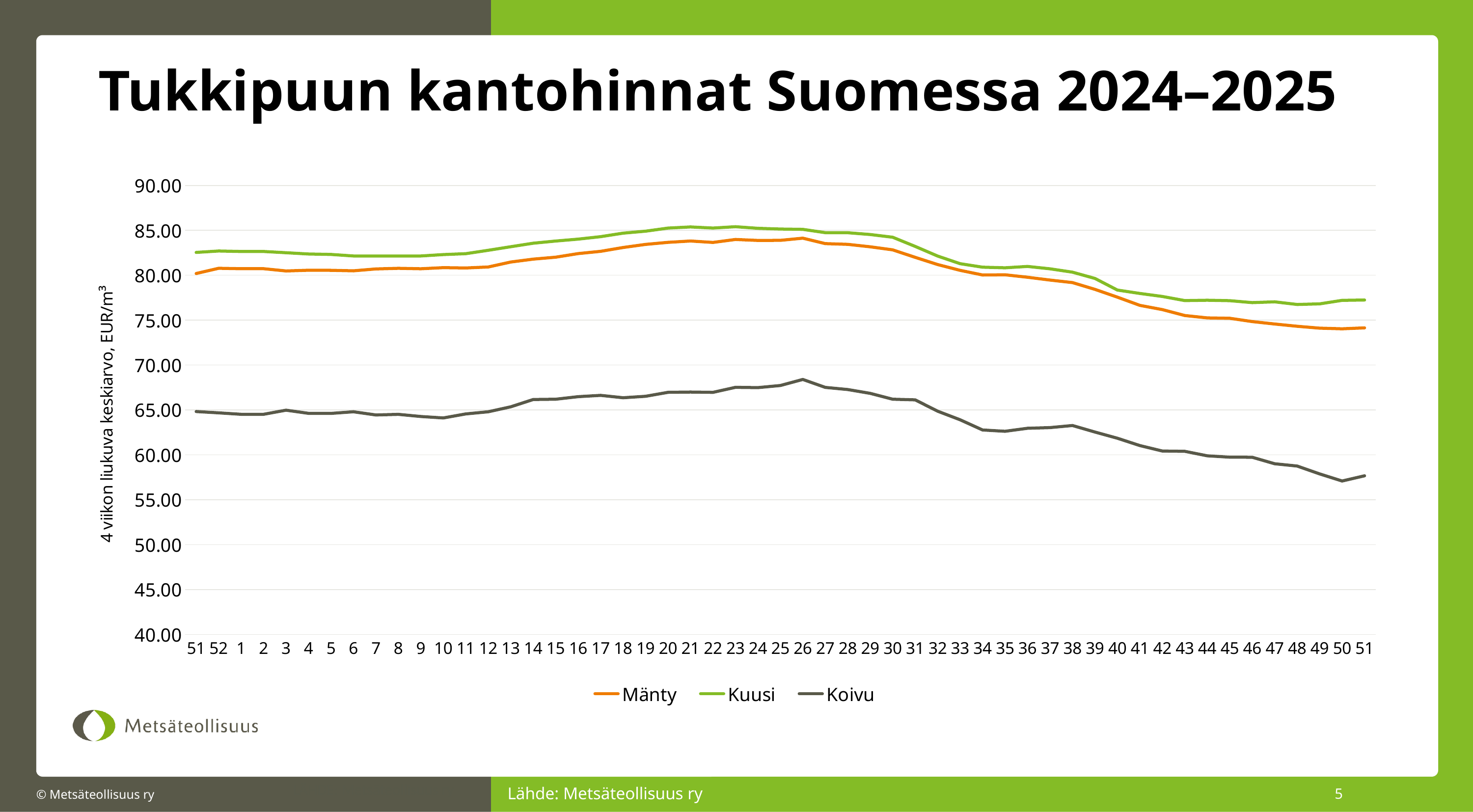
Is the value for Kuusi at week 1 greater or less than 80? greater Does the Koivu line rise or fall from week 26 to week 50? fall How many series does the legend list? 3 What is the title of the chart? Tukkipuun kantohinnat Suomessa 2024–2025 Is the value for Mänty at the last week 51 greater or less than 75? less Does the Mänty line rise or fall from week 12 to week 26? rise Which series has the highest values across the chart? Kuusi What kind of chart is shown on the slide? line chart Which series has the lowest values across the chart? Koivu At week 26, which is larger, the value for Kuusi or the value for Mänty? Kuusi Is the value for Koivu at week 50 greater or less than 60? less